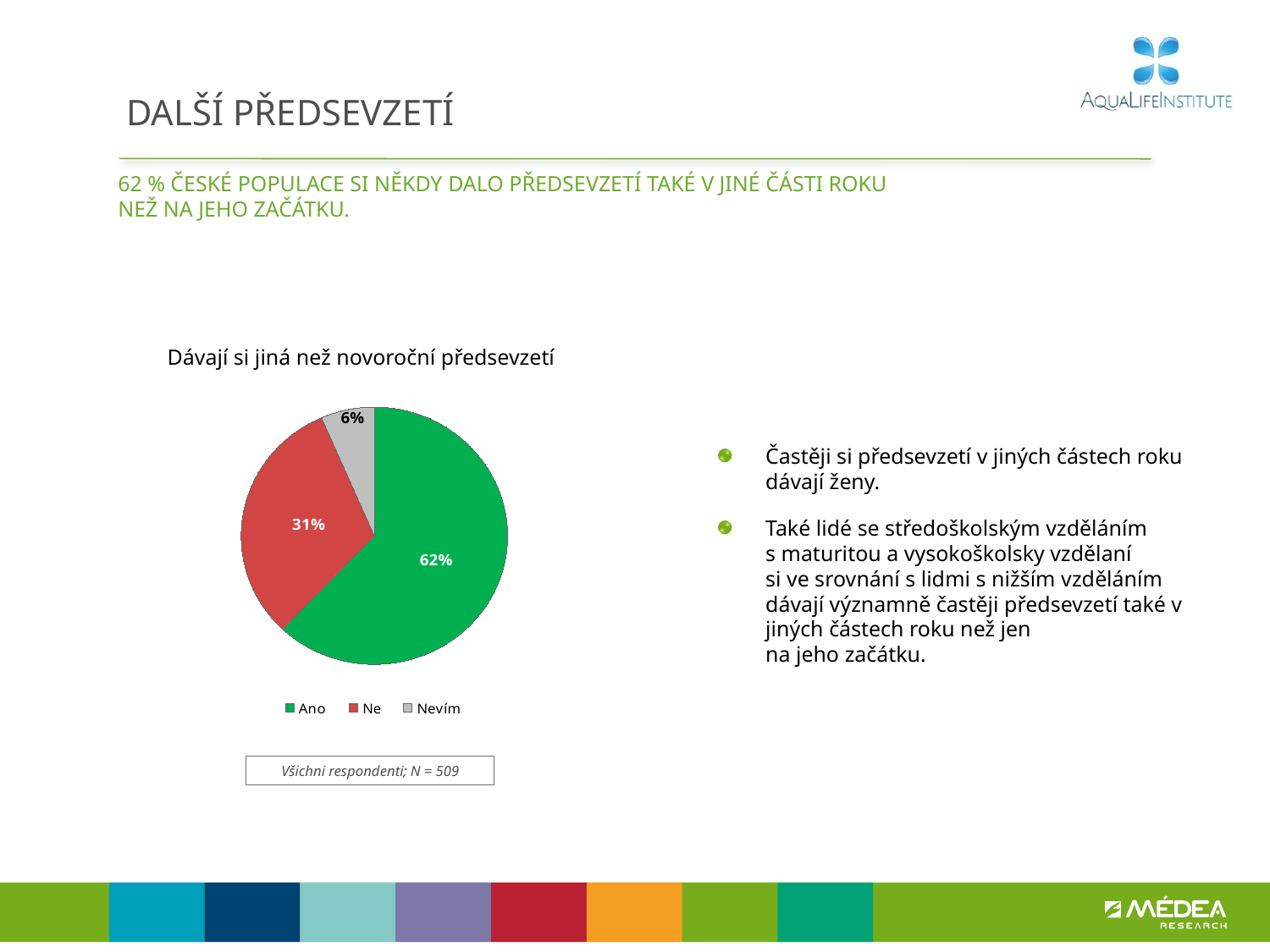
What share of the pie does "Ano" take? 62% What is the value for "Ne"? 31% What colour is the "Ano" slice? green Which is larger, "Ne" or "Nevím"? Ne What is the difference between the "Ne" and "Nevím" values? 25% Which category has the smallest slice? Nevím What kind of chart is shown on the slide? pie chart What is the difference between the "Ano" and "Ne" values? 31% What is the title of the chart? Dávají si jiná než novoroční předsevzetí Which category has the largest slice? Ano How many categories does the pie chart have? 3 What is the value for "Nevím"? 6%